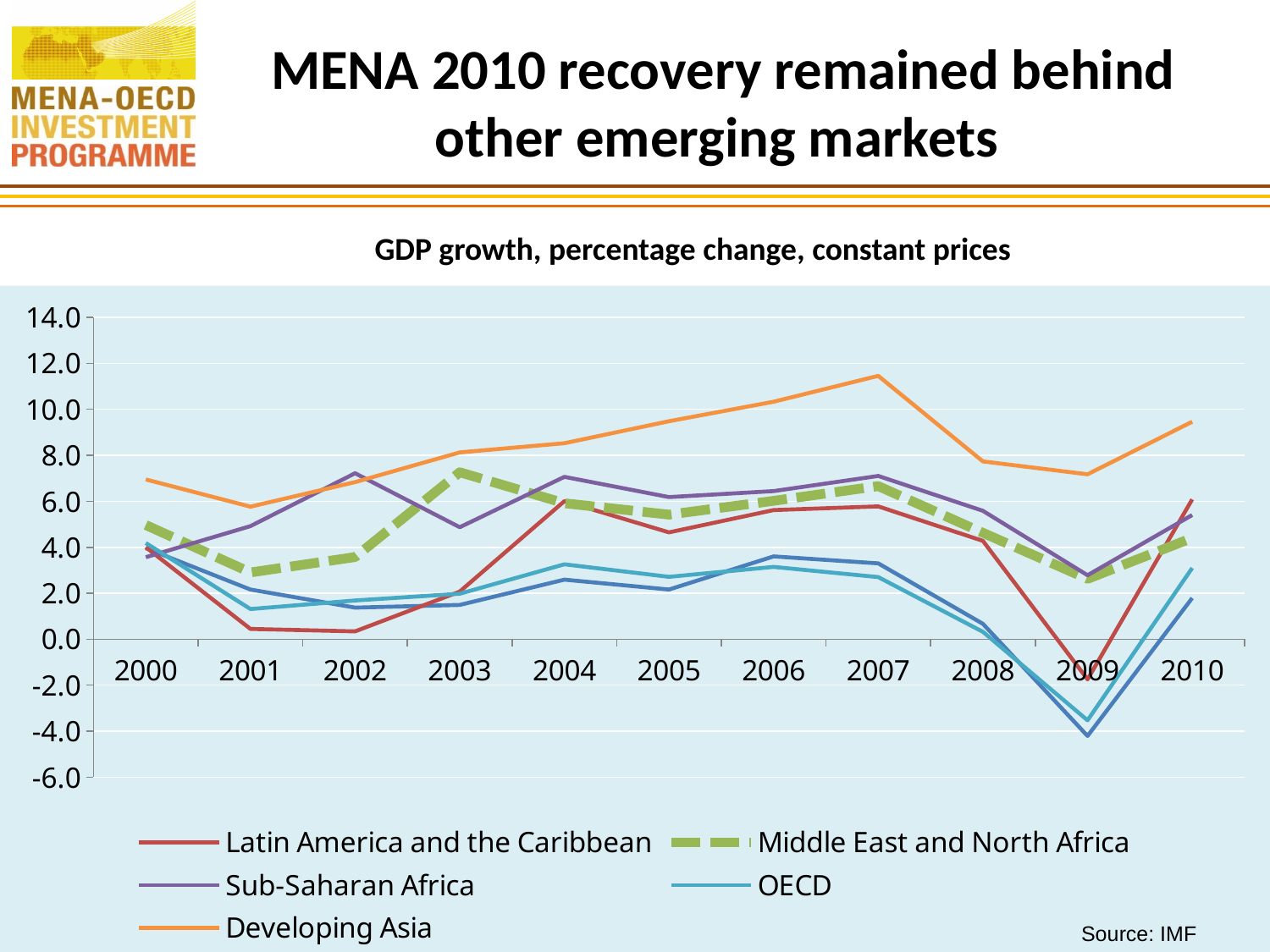
Does the Developing Asia line rise or fall from 2003 to 2007? rises Is the value for Latin America and the Caribbean in 2009 greater or less than 0.0? less Which series has the highest value in 2007? Developing Asia Is the value for Middle East and North Africa in 2003 greater or less than 6.0? greater How many years are shown along the x axis of the chart? 11 How many series does the chart's legend list? 5 Is the value for OECD in 2009 greater or less than -2.0? less What is the title of the chart? GDP growth, percentage change, constant prices In 2010, which is larger: the value for Developing Asia or the value for Latin America and the Caribbean? Developing Asia What kind of chart is shown on the slide? line chart